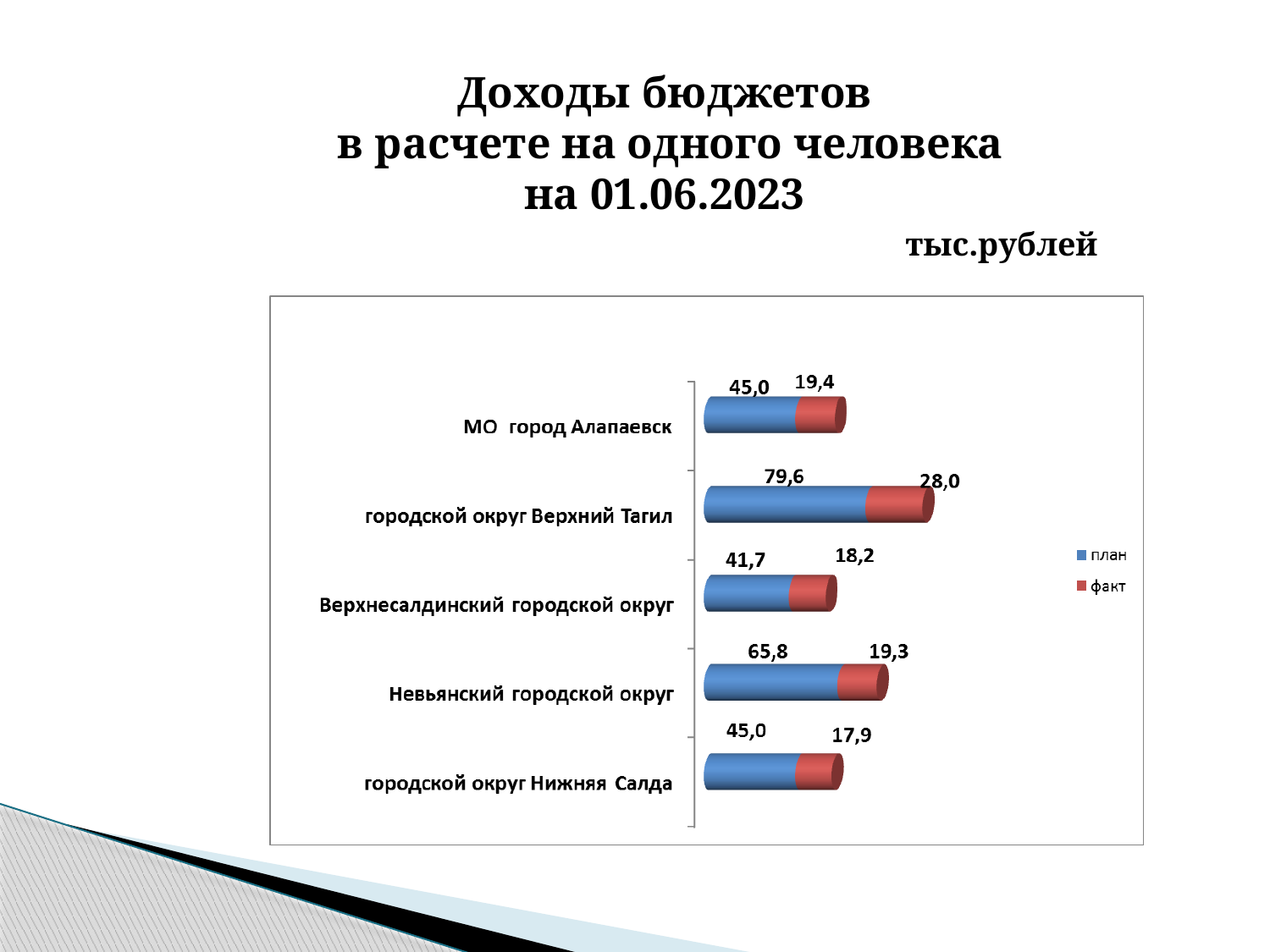
Which category has the highest план value? городской округ Верхний Тагил How many series does the legend list? 2 What is the факт value for Верхнесалдинский городской округ? 18,2 Which is larger: the факт value for МО город Алапаевск or the факт value for Невьянский городской округ? МО город Алапаевск How many categories are shown on the chart? 5 What is the факт value for городской округ Нижняя Салда? 17,9 Which category has the lowest факт value? городской округ Нижняя Салда What is the план value for городской округ Верхний Тагил? 79,6 Which colour represents the факт series in the legend? Red What kind of chart is shown on the slide? Stacked bar chart What is the total of the stacked bar for городской округ Верхний Тагил? 107,6 What is the difference between the план and факт values for Невьянский городской округ? 46,5